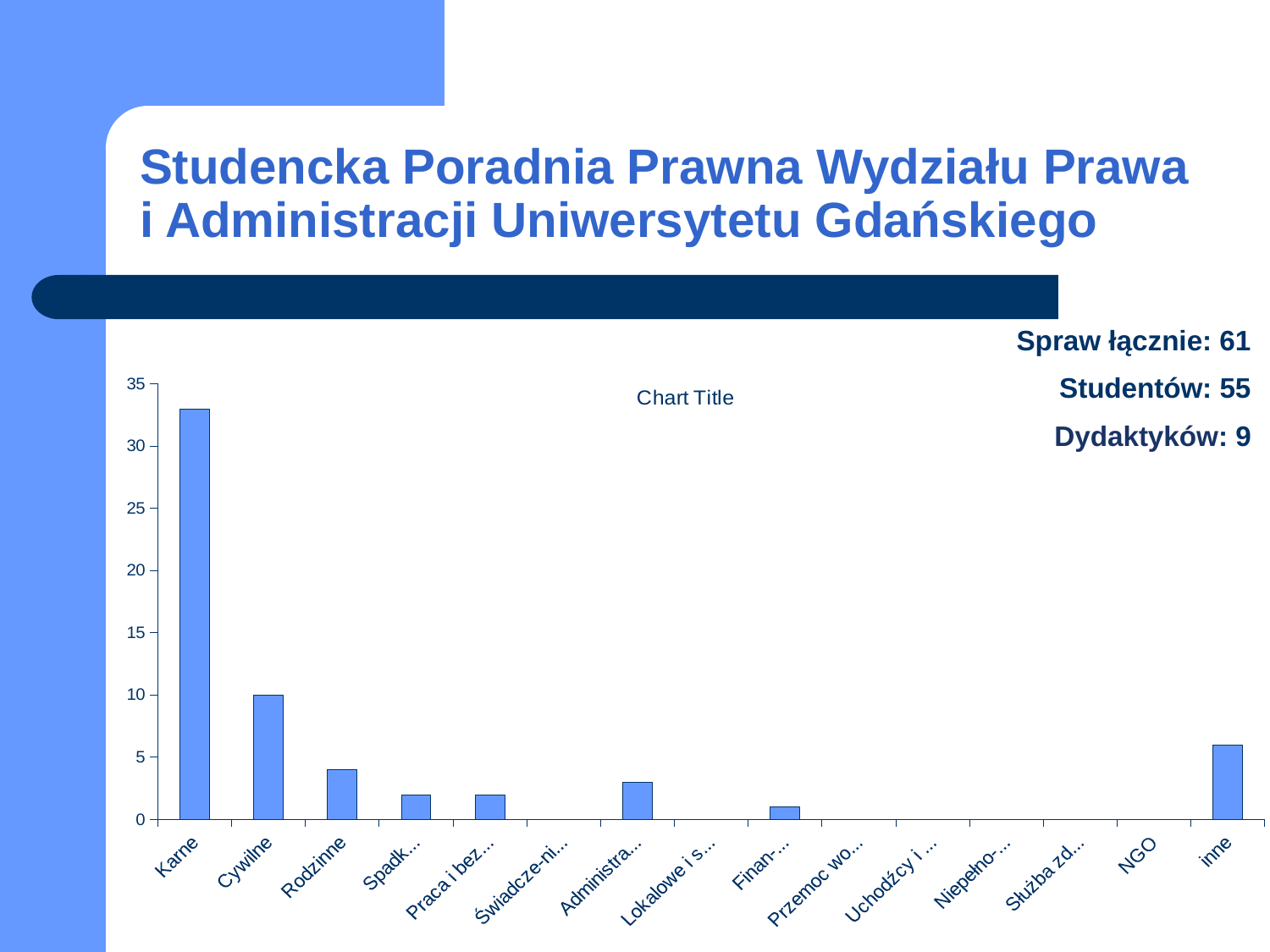
Is the value for Karne greater or less than 35? less Is the value for Karne greater or less than 30? greater Which is larger, the value for Karne or the value for Cywilne? Karne What is the value for Cywilne? 10 Which is larger, the value for inne or the value for Rodzinne? inne Which category has the highest value in the chart? Karne How many categories are shown on the x axis of the chart? 15 What is the title shown on the chart? Chart Title Is the value for inne greater or less than 5? greater What kind of chart is shown on the slide? bar chart